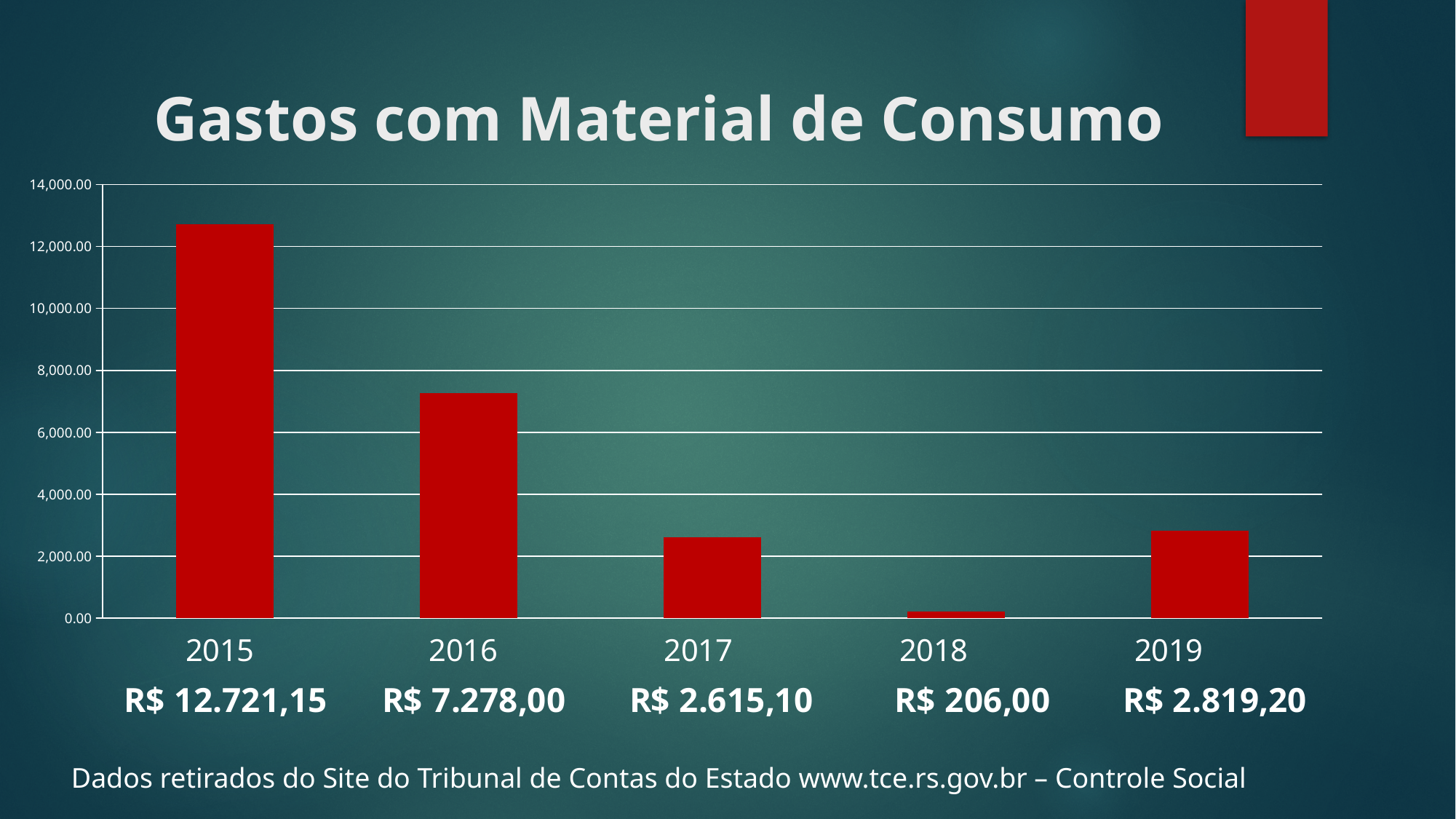
What is the value for 2019? R$ 2.819,20 Which is larger, the value for 2017 or the value for 2019? 2019 What is the value for 2018? R$ 206,00 What is the value for 2015? R$ 12.721,15 What is the difference between the values for 2015 and 2016? R$ 5.443,15 Do the values rise or fall from 2015 to 2018? fall Which year has the highest spending? 2015 Which year has the lowest spending? 2018 What is the difference between the values for 2019 and 2017? R$ 204,10 What kind of chart is shown on the slide? bar chart Is the value for 2016 greater or less than 8,000.00? less How many years are shown on the x axis? 5